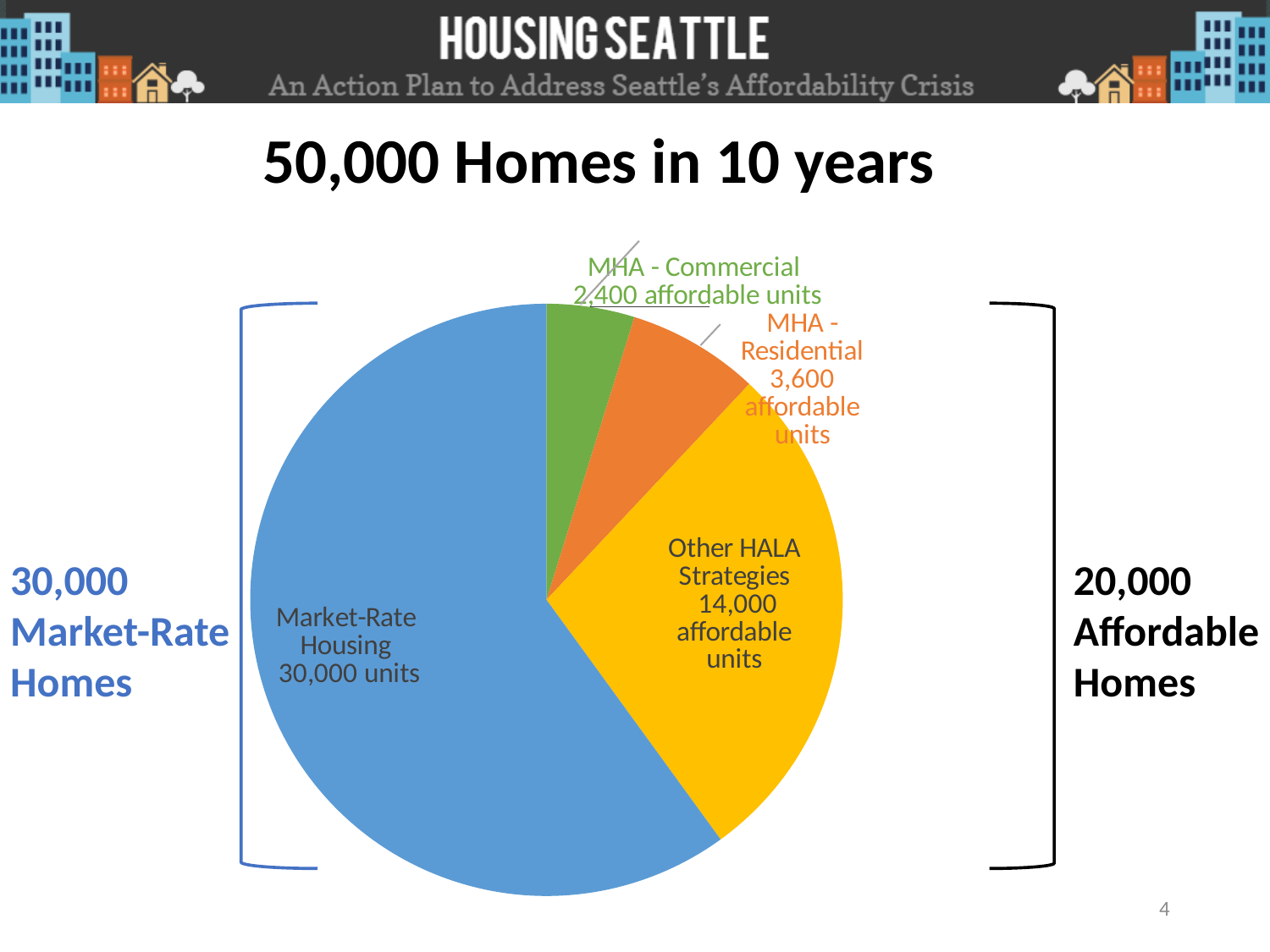
How many slices does the pie chart have? 4 What is the difference in units between MHA - Residential and MHA - Commercial? 1,200 Which is larger, Other HALA Strategies or MHA - Residential? Other HALA Strategies What share of the pie does the Market-Rate Housing slice represent? 60% Which slice of the pie chart is the smallest? MHA - Commercial How many units does the Market-Rate Housing slice represent? 30,000 units What type of chart is shown on the slide? pie chart Which slice of the pie chart is the largest? Market-Rate Housing How many affordable units does the MHA - Commercial slice represent? 2,400 affordable units What colour is the Other HALA Strategies slice? yellow How many affordable units does the Other HALA Strategies slice represent? 14,000 affordable units How many affordable units does the MHA - Residential slice represent? 3,600 affordable units